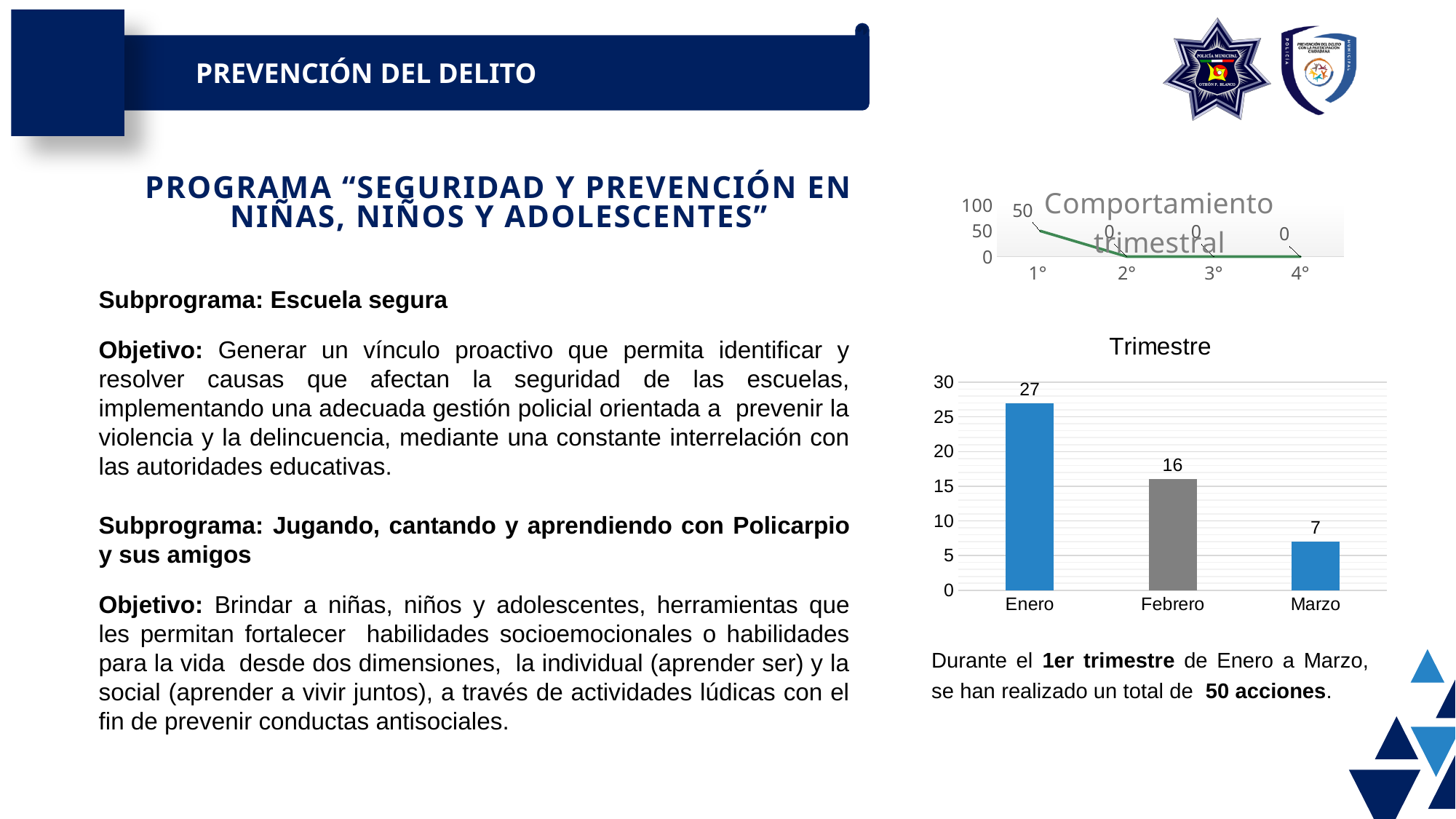
In the "Trimestre" chart, what is the value for Enero? 27 What kind of chart is the "Trimestre" chart? Bar chart In the "Trimestre" chart, which month has the lowest value? Marzo In the "Trimestre" chart, do the values rise or fall from Enero to Marzo? Fall In the "Trimestre" chart, which is larger, the value for Febrero or the value for Marzo? Febrero In the "Trimestre" chart, which month has the highest value? Enero In the "Comportamiento trimestral" chart, what is the value for 1°? 50 In the "Trimestre" chart, how many months are shown? 3 In the "Trimestre" chart, what is the value for Febrero? 16 In the "Trimestre" chart, what is the difference between the values for Enero and Febrero? 11 In the "Trimestre" chart, what is the value for Marzo? 7 What kind of chart is the "Comportamiento trimestral" chart? Line chart